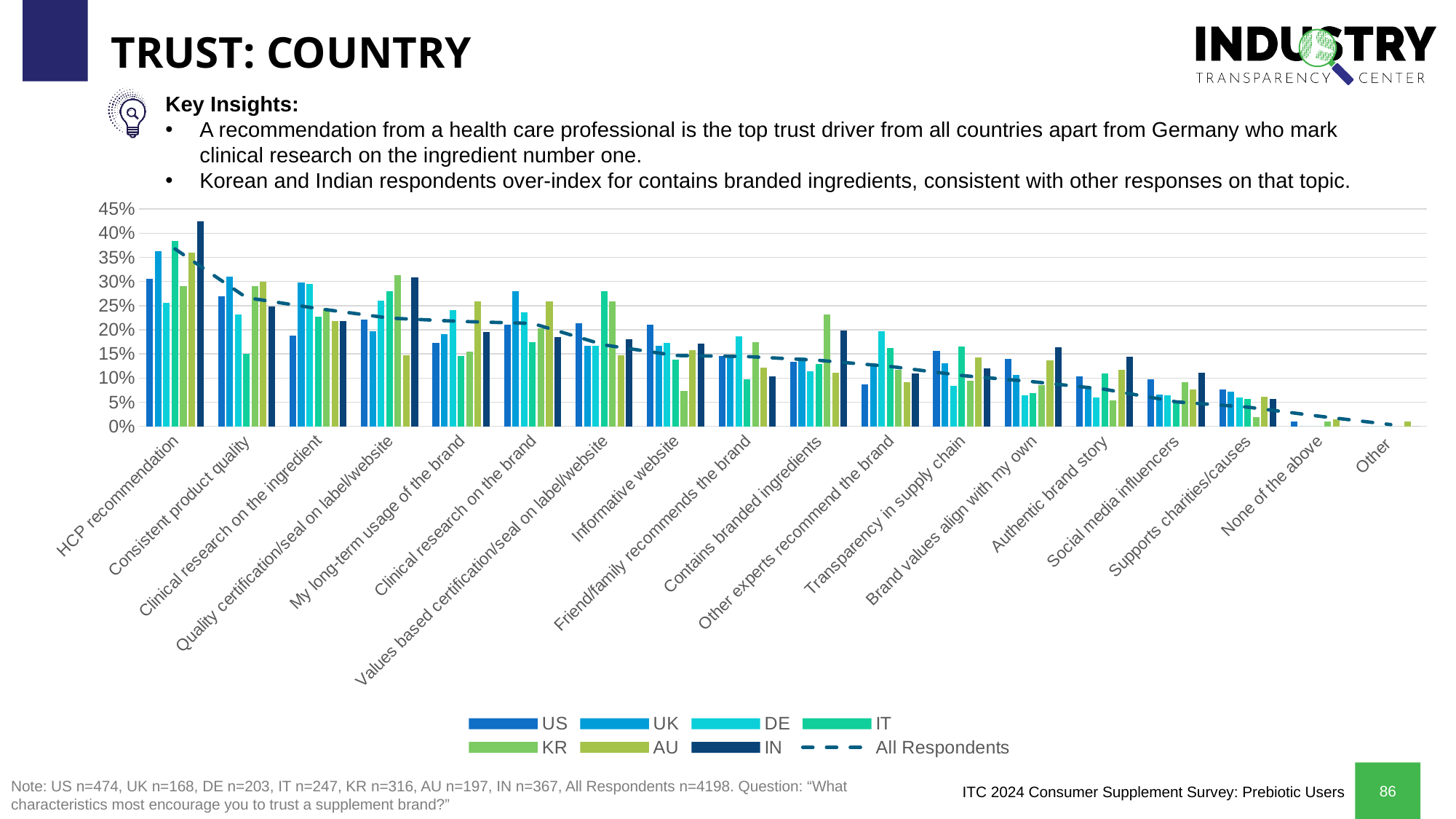
Which country has the highest bar for HCP recommendation? IN Is the value for IT on HCP recommendation greater or less than 35%? greater Is the value for US on None of the above greater or less than 5%? less Which country has the lowest bar for HCP recommendation? DE Which country has the highest bar for Contains branded ingredients? KR Is the value for IN on HCP recommendation greater or less than 40%? greater Which series is shown as a dashed line rather than bars? All Respondents How many categories are shown along the x axis? 18 What type of chart is shown on the slide? Combination bar and line chart (bars with a dashed line) How many series does the legend list? 8 Does the All Respondents dashed line rise or fall from left to right across the categories? Fall